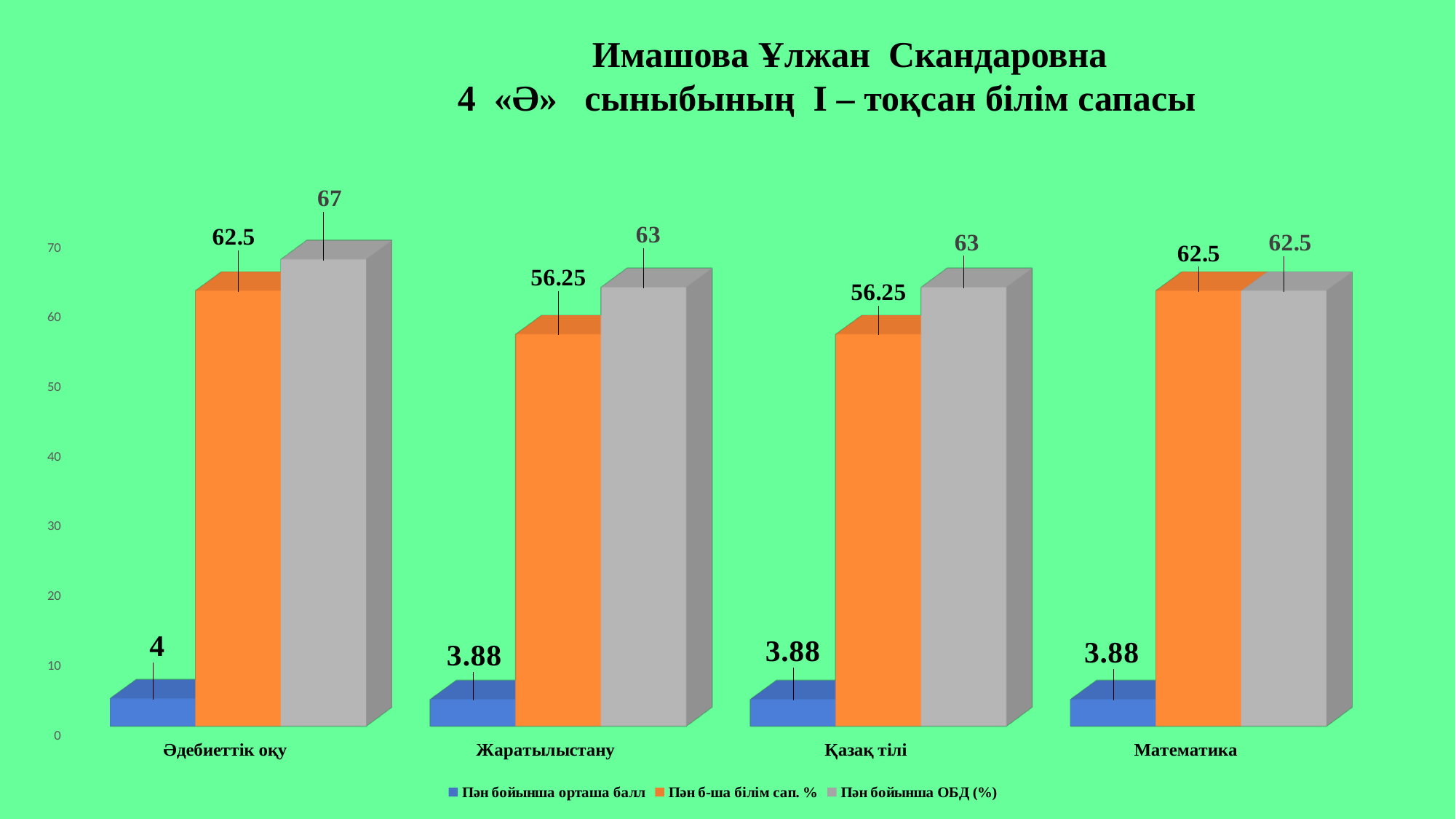
What is the value of Пән бойынша ОБД (%) for Әдебиеттік оқу? 67 Which category has the highest value for Пән бойынша ОБД (%)? Әдебиеттік оқу How many series does the legend list? 3 What kind of chart is shown on the slide? Bar chart Which category has the highest value for Пән бойынша орташа балл? Әдебиеттік оқу What is the difference between Пән бойынша ОБД (%) and Пән б-ша білім сап. % for Әдебиеттік оқу? 4.5 How many categories are shown on the x axis? 4 Which is larger: Пән б-ша білім сап. % for Әдебиеттік оқу or for Жаратылыстану? Әдебиеттік оқу What is the difference between Пән бойынша ОБД (%) and Пән б-ша білім сап. % for Қазақ тілі? 6.75 What is the value of Пән бойынша орташа балл for Математика? 3.88 What is the value of Пән бойынша орташа балл for Әдебиеттік оқу? 4 What is the value of Пән б-ша білім сап. % for Жаратылыстану? 56.25